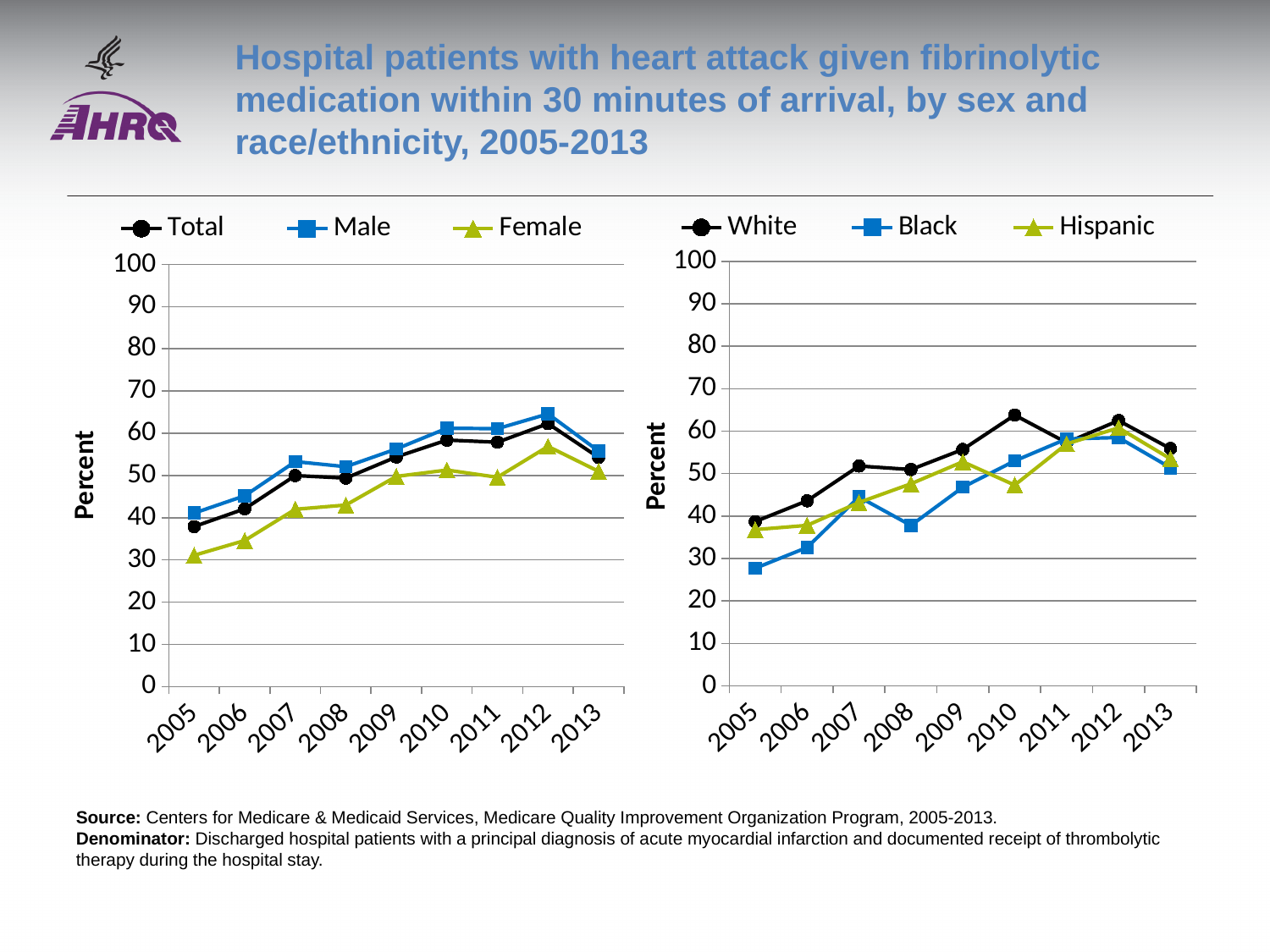
How many series does the legend of the right chart list? 3 In the left chart, which is larger in 2005, Male or Female? Male In the right chart, is the value for White in 2010 greater or less than 60? greater What kind of chart is the left chart (Total, Male, Female)? Line chart In the right chart, which series has the highest value in 2010? White In the left chart, is the value for Male in 2012 greater or less than 60? greater In the left chart, does the Total series generally rise or fall from 2005 to 2012? Rise How many years are plotted along the x axis of the left chart? 9 In the right chart, is the value for Hispanic in 2010 greater or less than 50? less In the right chart, which series has the lowest value in 2005? Black